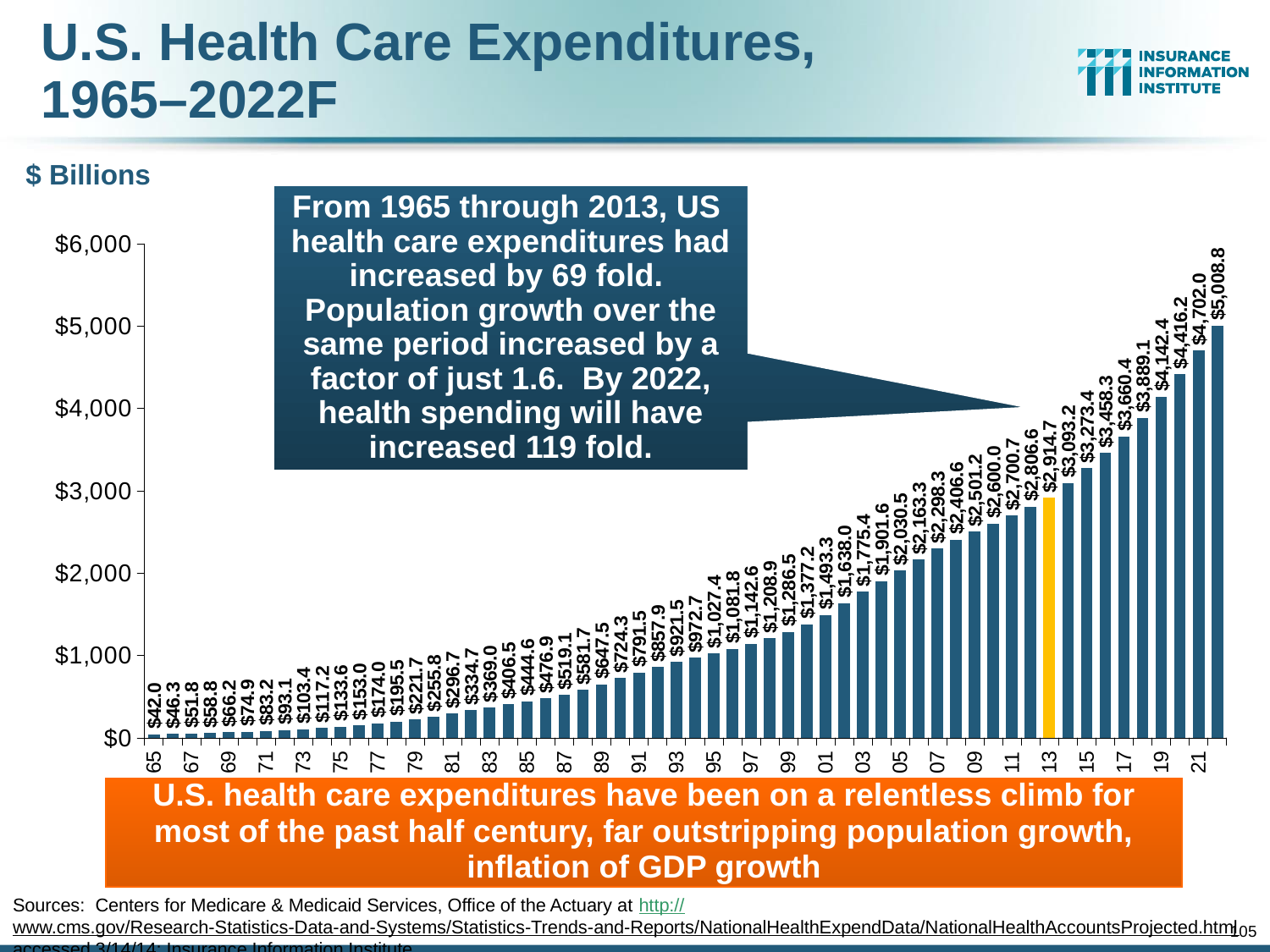
What is the value for 2022, the last bar? $5,008.8 Which year has the lowest expenditure? 1965 What is the difference between the 2022 value and the 2013 value? $2,094.1 What is the value for 2000 (labelled 01 is 2001; the bar labelled 99 is 1999)? Give the value for the bar labelled 99. $1,286.5 What kind of chart is shown on the slide? Bar chart Which is larger, the value for 1985 or the value for 1995? 1995 What is the value for 2013, the highlighted bar? $2,914.7 Do the values rise or fall from 1965 to 2022? Rise Which year has the highest expenditure? 2022 How many bars (years) are plotted in the chart? 58 What is the value for 1965 (the first bar)? $42.0 Is the value for 2010 greater or less than $2,000? greater